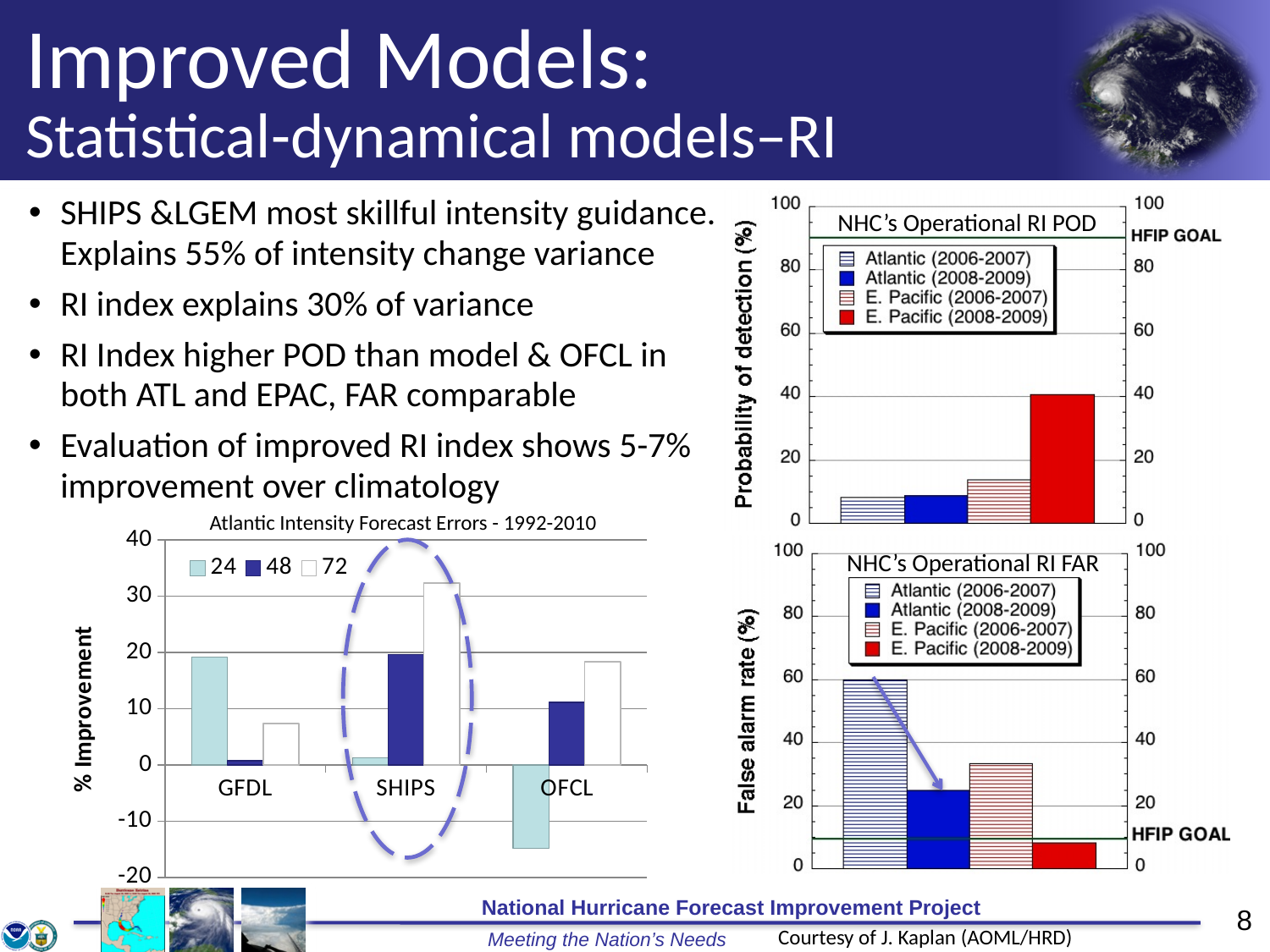
In the 'NHC's Operational RI POD' chart, how many series does the legend list? 4 In the 'Atlantic Intensity Forecast Errors - 1992-2010' chart, which is larger: the 24 value for GFDL or the 24 value for SHIPS? GFDL In the 'NHC's Operational RI FAR' chart, which series has the highest false alarm rate? Atlantic (2006-2007) In the 'Atlantic Intensity Forecast Errors - 1992-2010' chart, is the 24 value for OFCL greater or less than 0? less In the 'NHC's Operational RI POD' chart, which series has the highest probability of detection? E. Pacific (2008-2009) In the 'Atlantic Intensity Forecast Errors - 1992-2010' chart, how many categories are shown on the x axis? 3 What kind of chart is the 'Atlantic Intensity Forecast Errors - 1992-2010' chart? bar chart In the 'NHC's Operational RI FAR' chart, is the value for Atlantic (2006-2007) greater or less than 40? greater In the 'Atlantic Intensity Forecast Errors - 1992-2010' chart, which category has the highest value for the 72 series? SHIPS In the 'Atlantic Intensity Forecast Errors - 1992-2010' chart, is the 72 value for SHIPS greater or less than 30? greater In the 'NHC's Operational RI FAR' chart, which series has the lowest false alarm rate? E. Pacific (2008-2009) In the 'Atlantic Intensity Forecast Errors - 1992-2010' chart, how many series does the legend list? 3